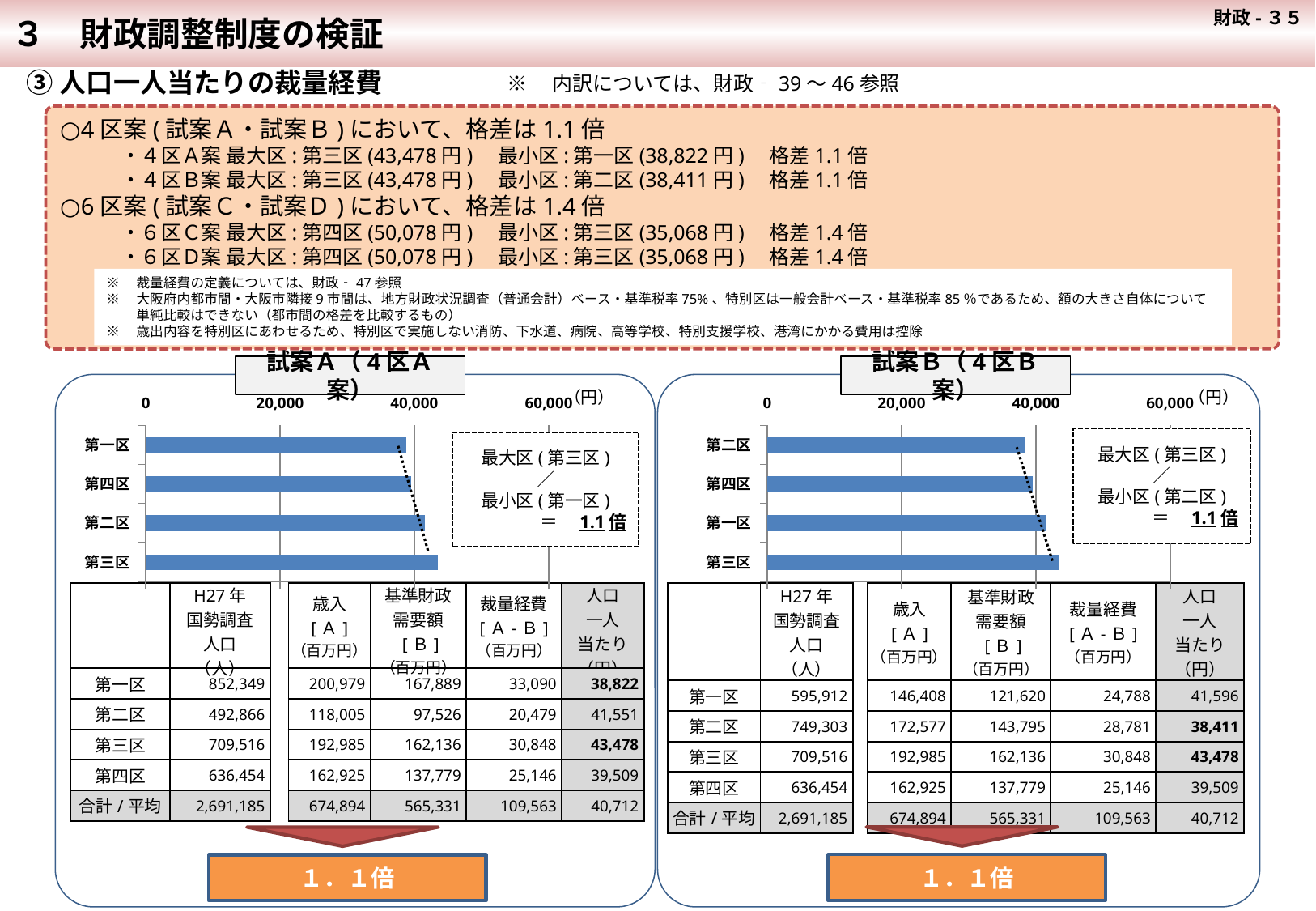
According to the 人口一人当たり column of the 試案A（4区A案） table, what is the value for 第三区? 43,478 What ratio (倍) between the largest and smallest district is shown in the orange box below the 試案B（4区B案） chart? 1.1倍 How many districts (categories) are plotted in the 試案A（4区A案） chart? 4 In the 試案B（4区B案） chart, which district has the shortest bar? 第二区 In the 試案A（4区A案） chart, which district has the longest bar? 第三区 In 試案A（4区A案）, what is the difference between the 人口一人当たり values of 第三区 (43,478) and 第一区 (38,822)? 4,656 In the 試案A（4区A案） chart, is the value for 第三区 greater or less than 40,000? greater In the 試案B（4区B案） chart, is the value for 第二区 greater or less than 40,000? less In the 試案A（4区A案） chart, which district has the shortest bar? 第一区 In the 試案A（4区A案） chart, is the value for 第一区 greater or less than 40,000? less What kind of chart is used in the 試案A（4区A案） panel? bar chart In the 試案B（4区B案） chart, which district has the longest bar? 第三区